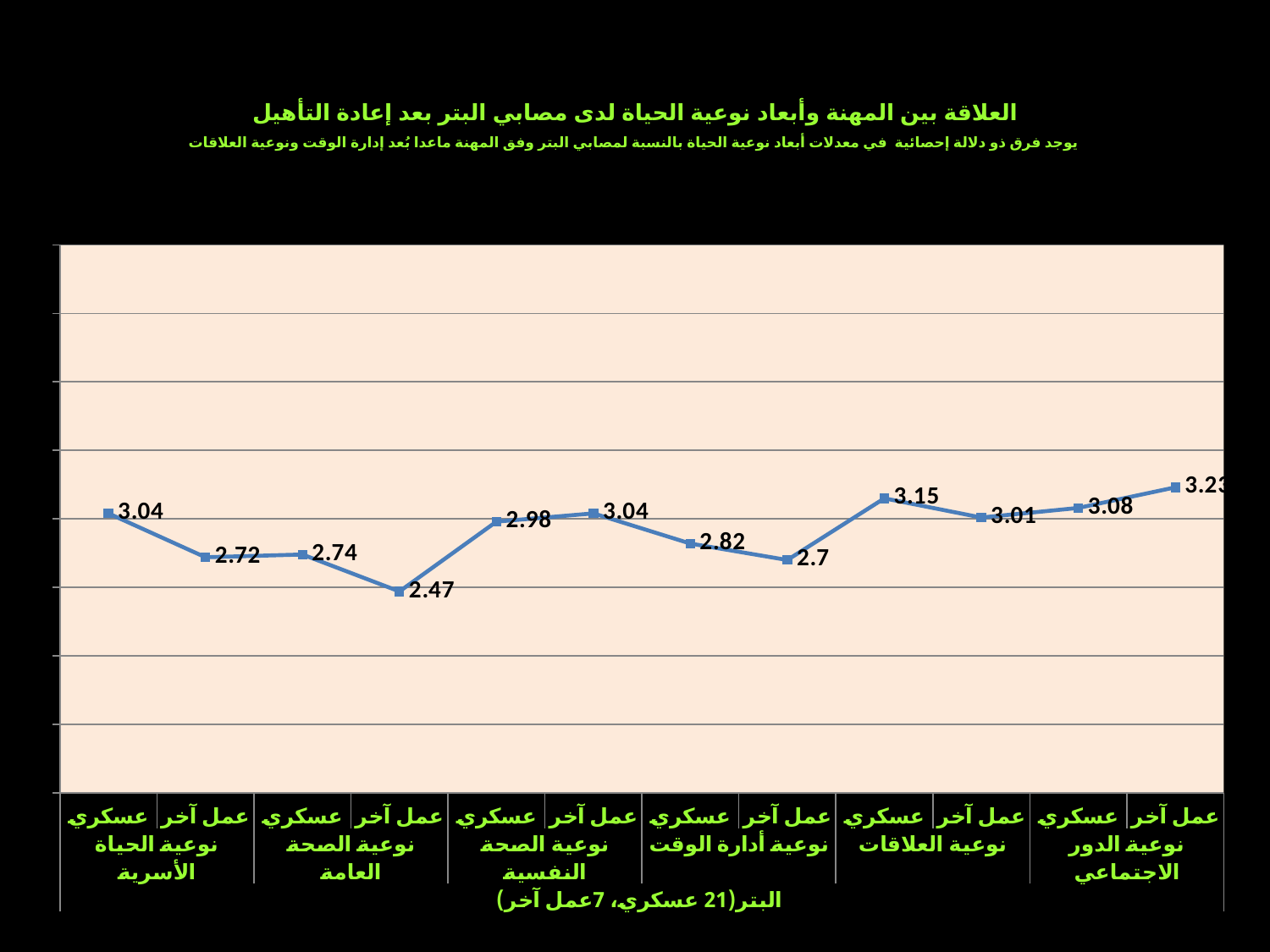
Under نوعية أدارة الوقت, which is larger: the عسكري value or the عمل آخر value? عسكري What is the value for عسكري under نوعية العلاقات? 3.15 What is the value for عمل آخر under نوعية الصحة العامة? 2.47 What type of chart is shown on the slide? line chart Under نوعية الصحة النفسية, which is larger: the عسكري value or the عمل آخر value? عمل آخر Which data point has the highest value on the chart? عمل آخر under نوعية الدور الاجتماعي (3.23) Which data point has the lowest value on the chart? عمل آخر under نوعية الصحة العامة (2.47) What is the value for عمل آخر under نوعية الدور الاجتماعي? 3.23 How many data points are plotted on the line? 12 What is the difference between the عسكري and عمل آخر values under نوعية الحياة الأسرية? 0.32 What is the value for عسكري under نوعية الحياة الأسرية? 3.04 What is the x-axis title shown below the category labels? البتر(21 عسكري، 7عمل آخر)